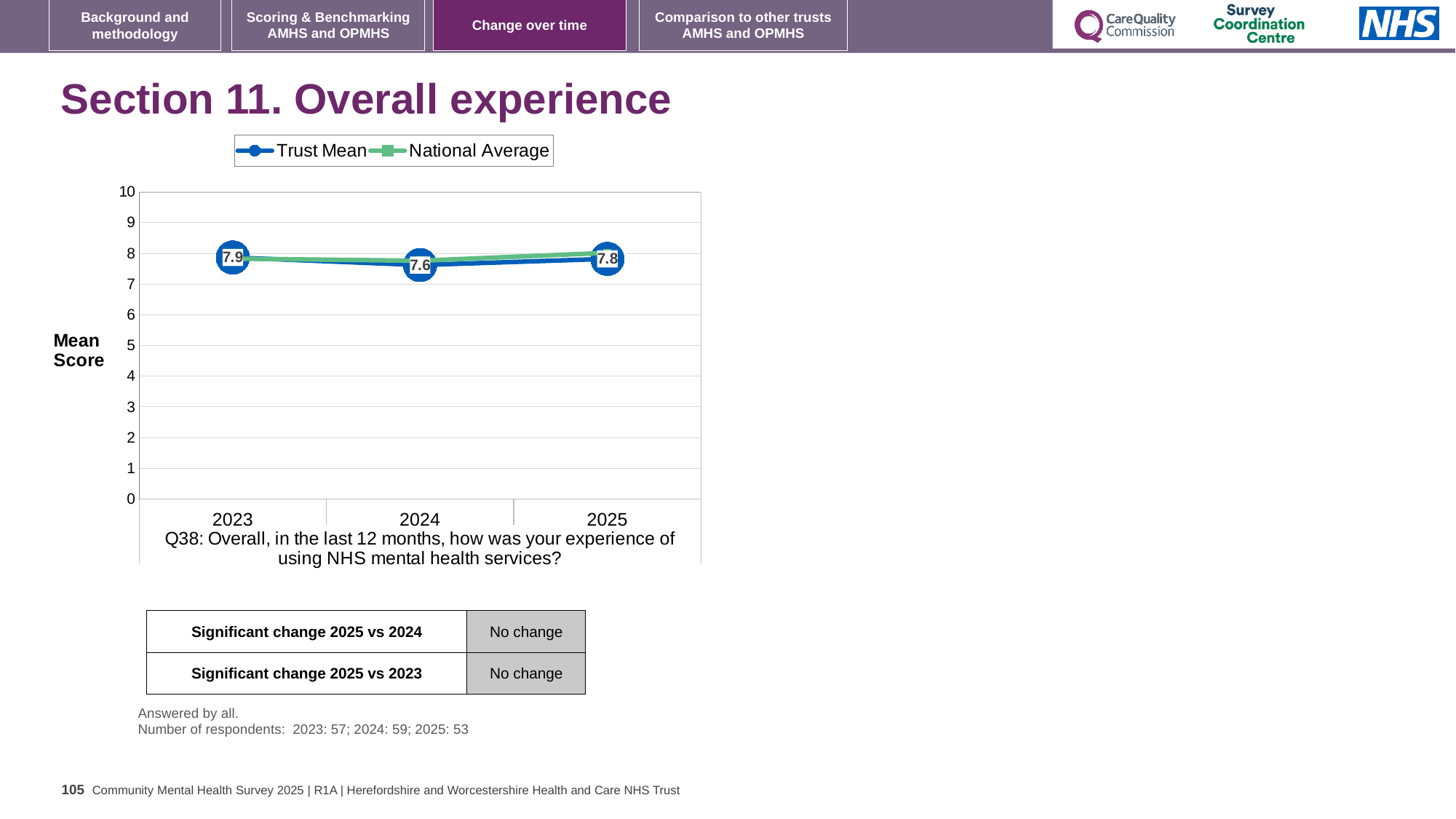
Which is larger, the Trust Mean in 2025 or the Trust Mean in 2024? 2025 What is the difference between the Trust Mean in 2023 and in 2024? 0.3 What is the Trust Mean value for 2023? 7.9 Between 2023 and 2024, does the Trust Mean rise or fall? Fall What is the Trust Mean value for 2025? 7.8 How many series does the legend list? 2 In which year is the Trust Mean highest? 2023 In which year is the Trust Mean lowest? 2024 What is the Trust Mean value for 2024? 7.6 Is the National Average value for 2025 greater or less than 7? greater What kind of chart is shown on the slide? Line chart How many years are plotted on the x axis? 3